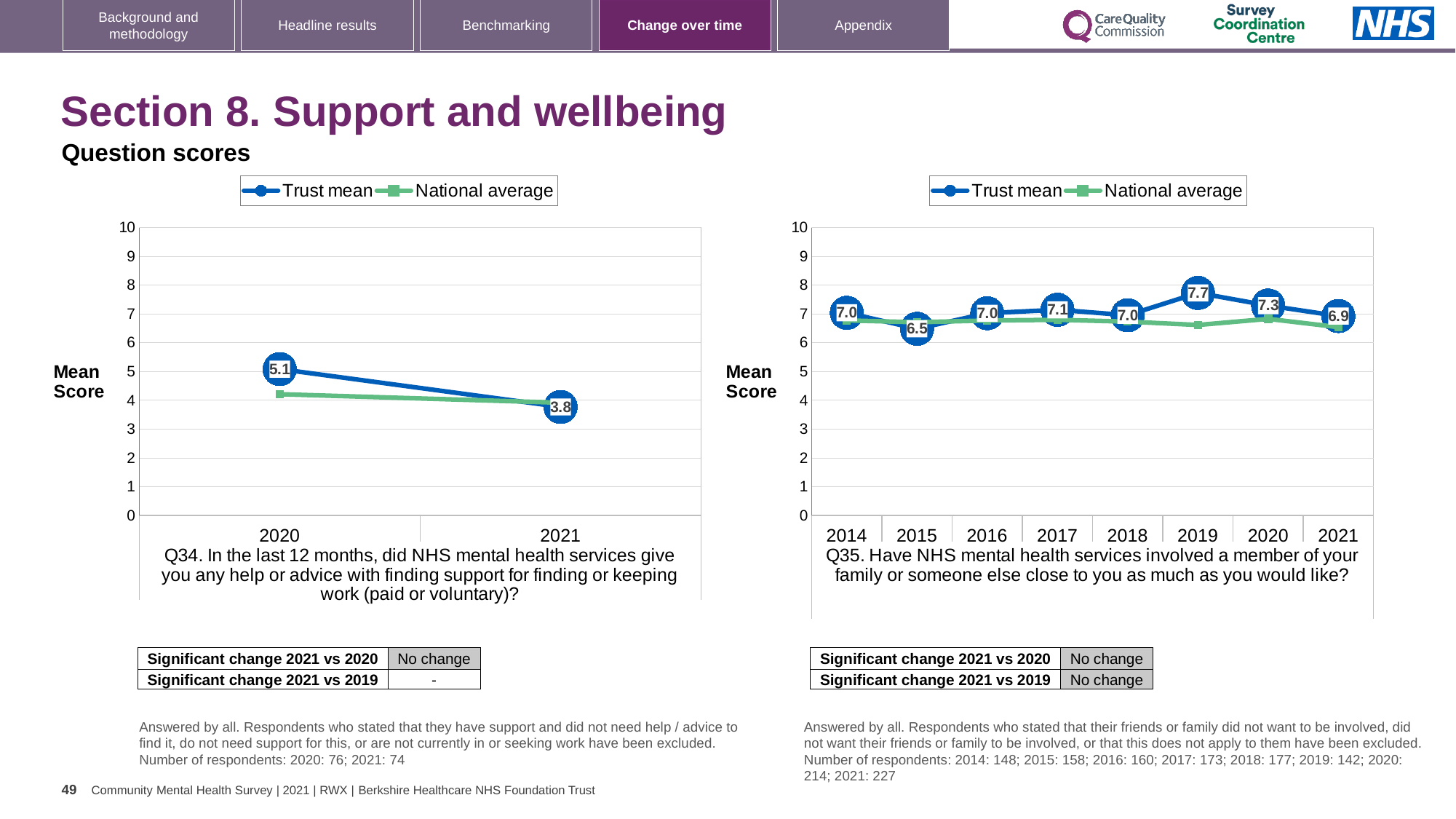
In the Q35 chart on the right, what is the difference between the Trust mean in 2019 and in 2021? 0.8 In the Q35 chart on the right, which year has the lowest Trust mean score? 2015 What type of chart is the Q35 chart on the right? line chart In the Q34 chart on the left, what is the Trust mean score for 2020? 5.1 In the Q34 chart on the left, by how much did the Trust mean fall from 2020 to 2021? 1.3 In the Q35 chart on the right, how many years are plotted on the x axis? 8 In the Q34 chart on the left, does the Trust mean rise or fall from 2020 to 2021? fall In the Q35 chart on the right, which year has the highest Trust mean score? 2019 In the Q35 chart on the right, how many series does the legend list? 2 In the Q35 chart on the right, what is the Trust mean score for 2019? 7.7 In the Q34 chart on the left, is the National average for 2020 greater or less than 5? less In the Q34 chart on the left, what is the Trust mean score for 2021? 3.8